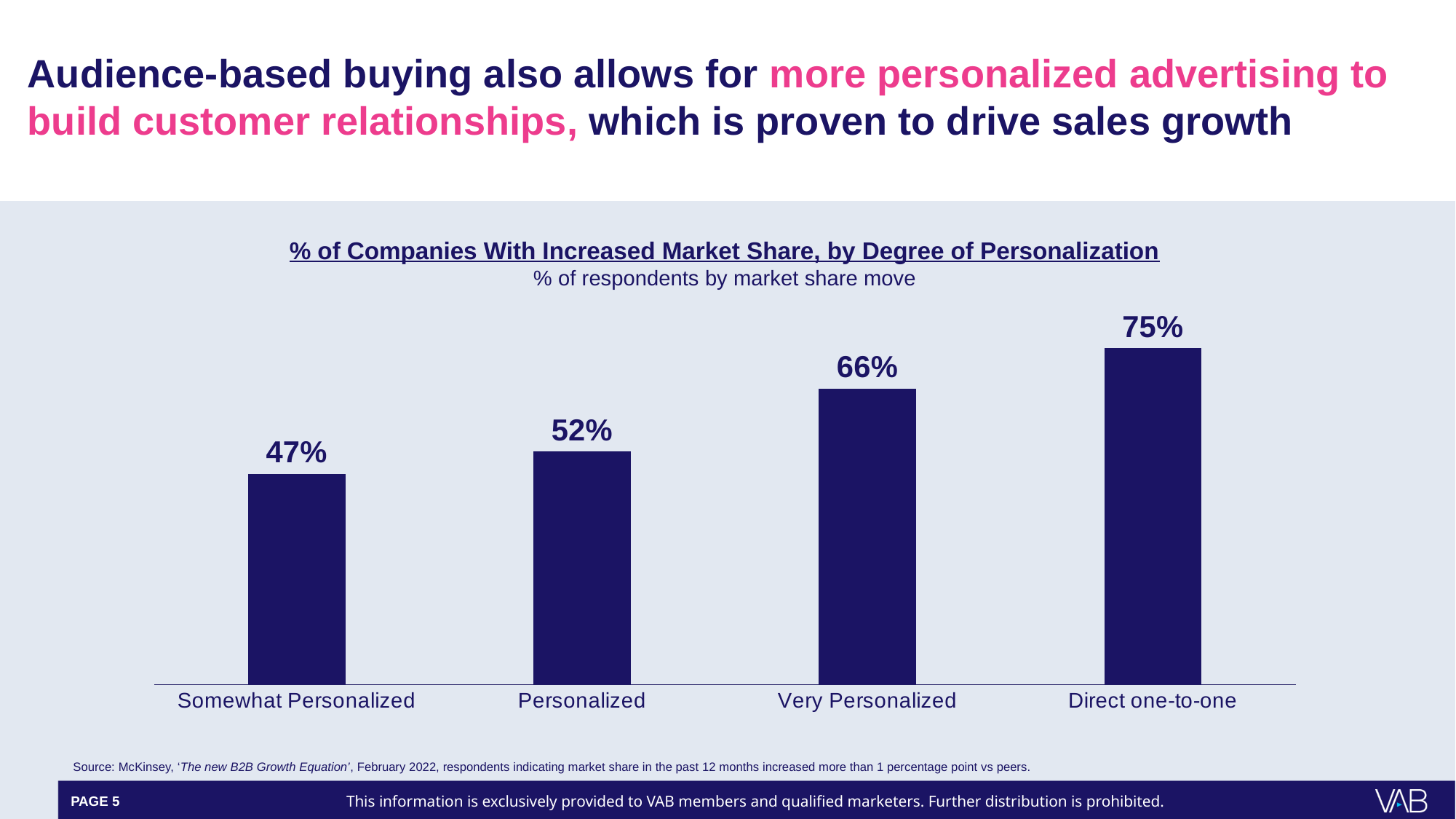
Do the values rise or fall as the degree of personalization increases from left to right? Rise Which degree of personalization has the highest percentage of companies with increased market share? Direct one-to-one What is the difference in percentage points between 'Direct one-to-one' and 'Somewhat Personalized'? 28 percentage points What percentage of companies with 'Somewhat Personalized' marketing reported increased market share? 47% Which has a higher value, 'Personalized' or 'Very Personalized'? Very Personalized What is the value shown for 'Direct one-to-one'? 75% What is the value shown for 'Very Personalized'? 66% Which degree of personalization has the lowest percentage of companies with increased market share? Somewhat Personalized What is the title of the chart? % of Companies With Increased Market Share, by Degree of Personalization What is the difference between the values for 'Very Personalized' and 'Personalized'? 14 percentage points What type of chart is shown on the slide? Bar chart How many degrees of personalization are shown on the chart? 4